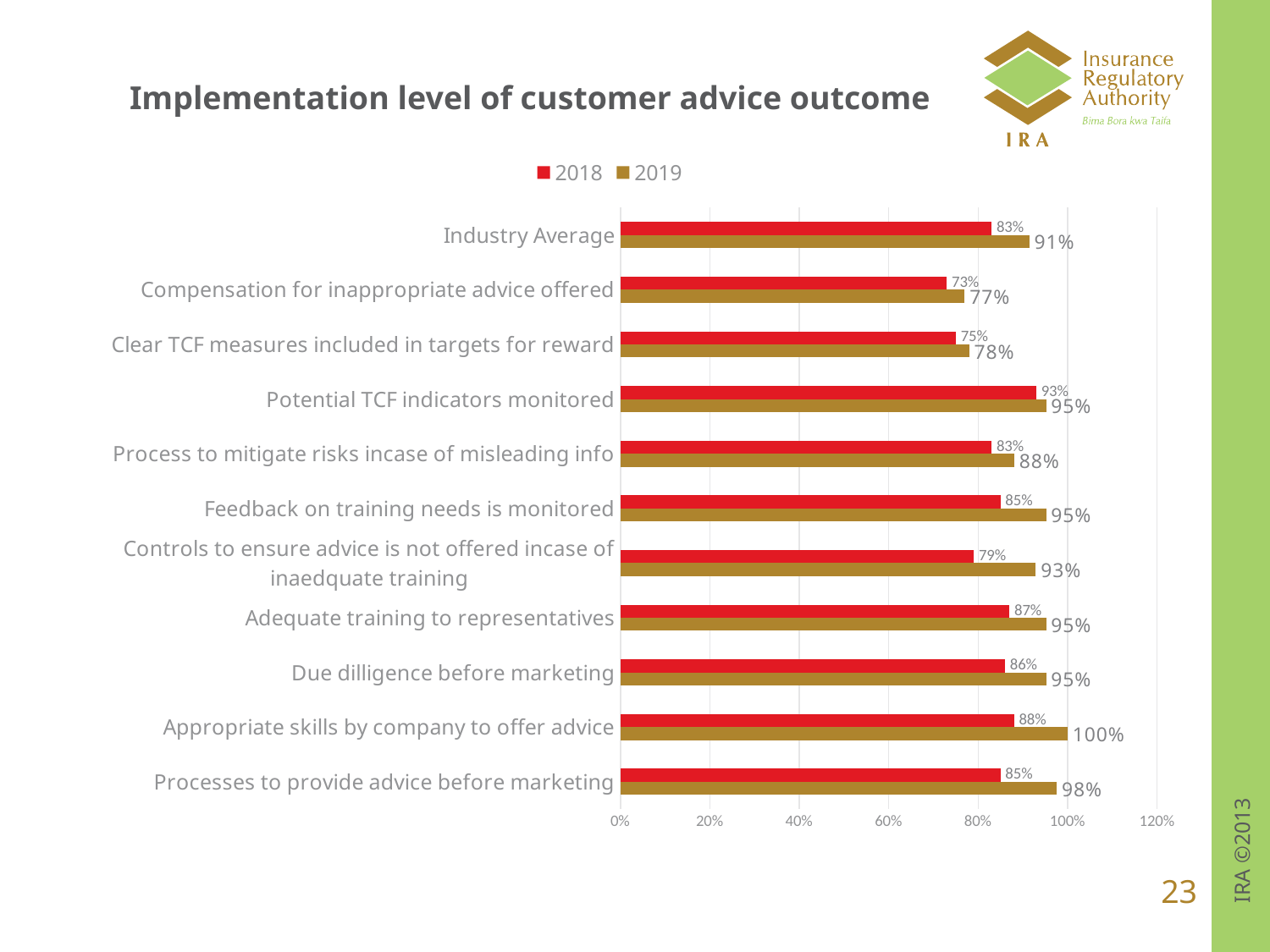
What is the difference between the 2019 and 2018 values for Processes to provide advice before marketing? 13% What is the 2018 value for Compensation for inappropriate advice offered? 73% What is the 2019 value for Appropriate skills by company to offer advice? 100% What kind of chart is shown on the slide? Bar chart Which category has the highest 2018 value? Potential TCF indicators monitored Which is larger for Feedback on training needs is monitored: the 2018 value or the 2019 value? 2019 What is the 2019 value for Industry Average? 91% What is the 2018 value for Controls to ensure advice is not offered incase of inaedquate training? 79% Which category has the highest 2019 value? Appropriate skills by company to offer advice How many series does the legend list? 2 How many categories are shown on the chart? 11 Which category has the lowest 2018 value? Compensation for inappropriate advice offered